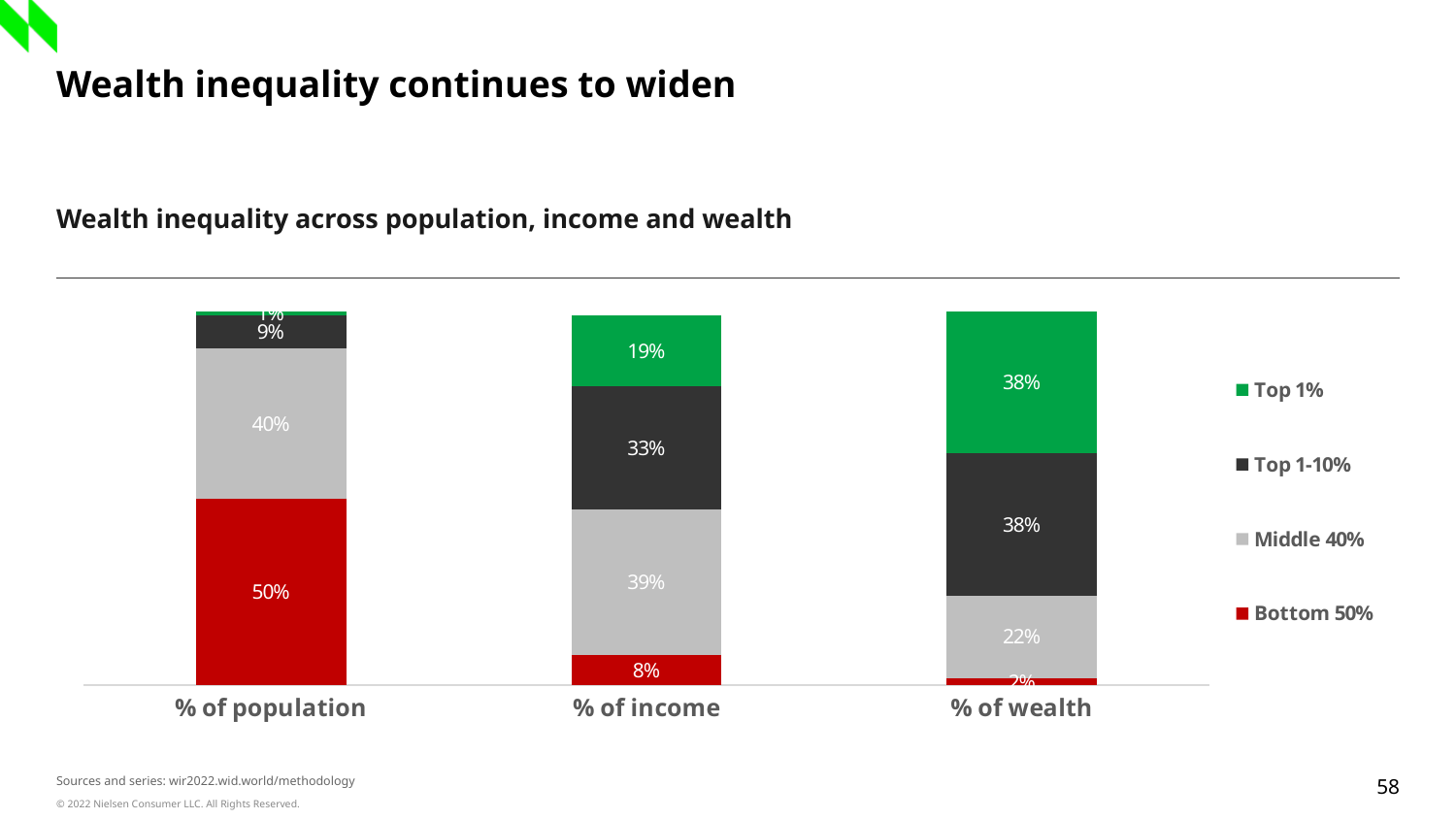
What kind of chart is shown on the slide? Stacked bar chart What is the Top 1-10% value for % of population? 9% Which is larger, the Middle 40% value for % of income or for % of wealth? % of income How many categories are shown on the x axis? 3 What is the difference between the Top 1% value for % of wealth and for % of income? 19 percentage points What is the Bottom 50% value for % of income? 8% Which category has the highest Top 1% value? % of wealth What is the Top 1% value for % of wealth? 38% What is the Middle 40% value for % of income? 39% How many series does the legend list? 4 What is the difference between the Bottom 50% value for % of population and for % of income? 42 percentage points Which category has the lowest Bottom 50% value? % of wealth